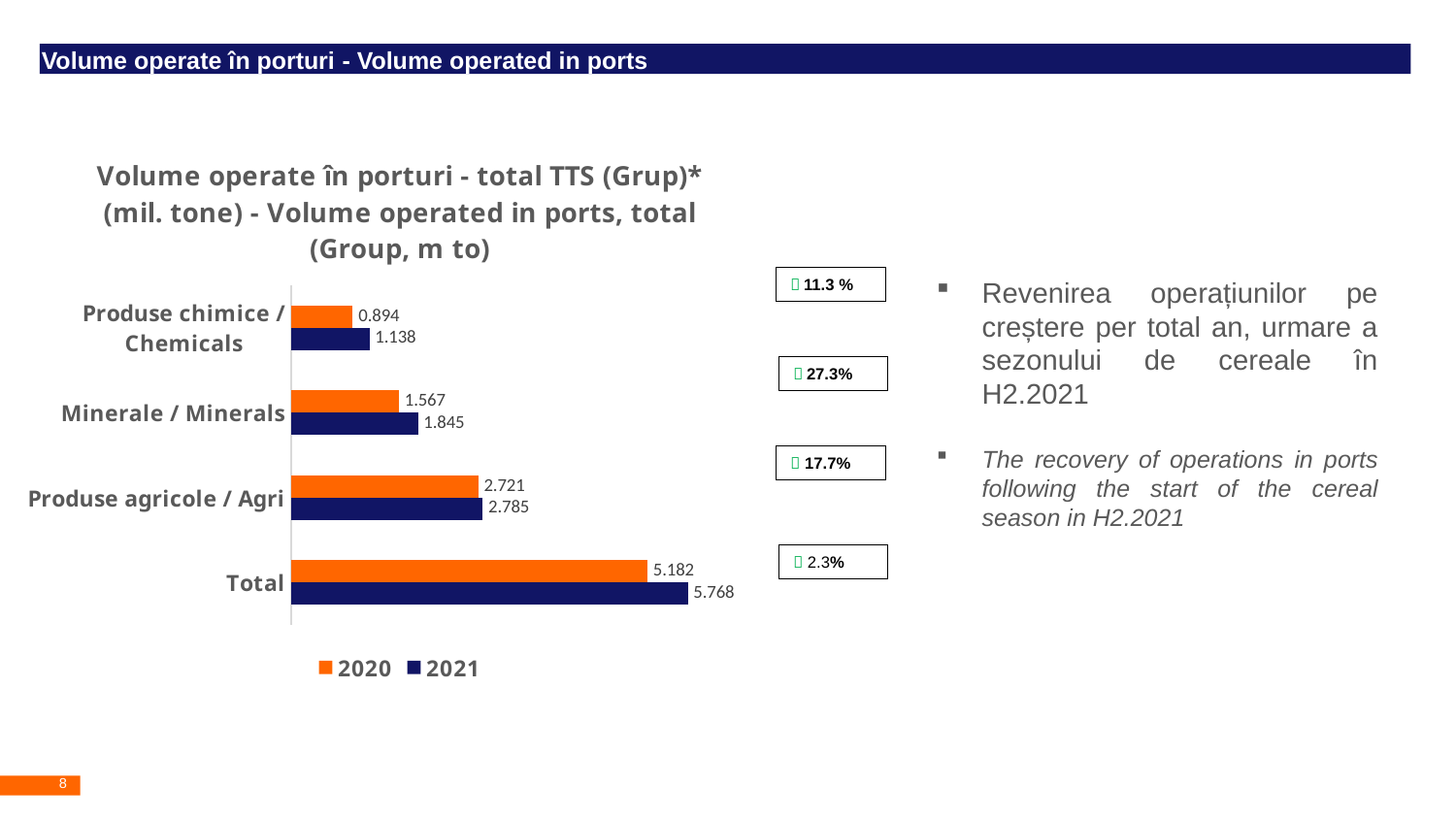
What kind of chart is shown on the slide? Bar chart What was the 2020 value for Minerale / Minerals? 1.567 What is the difference between the 2021 and 2020 Total values? 0.586 Which is larger for Produse chimice / Chemicals, the 2020 value or the 2021 value? 2021 What was the 2021 value for Produse agricole / Agri? 2.785 Which category has the lowest 2020 value? Produse chimice / Chemicals What was the 2021 value for Produse chimice / Chemicals? 1.138 How many categories are shown on the chart? 4 What was the Total value for 2020? 5.182 How many series does the legend list? 2 What is the difference between the 2021 and 2020 values for Minerale / Minerals? 0.278 Excluding Total, which category has the highest 2021 value? Produse agricole / Agri